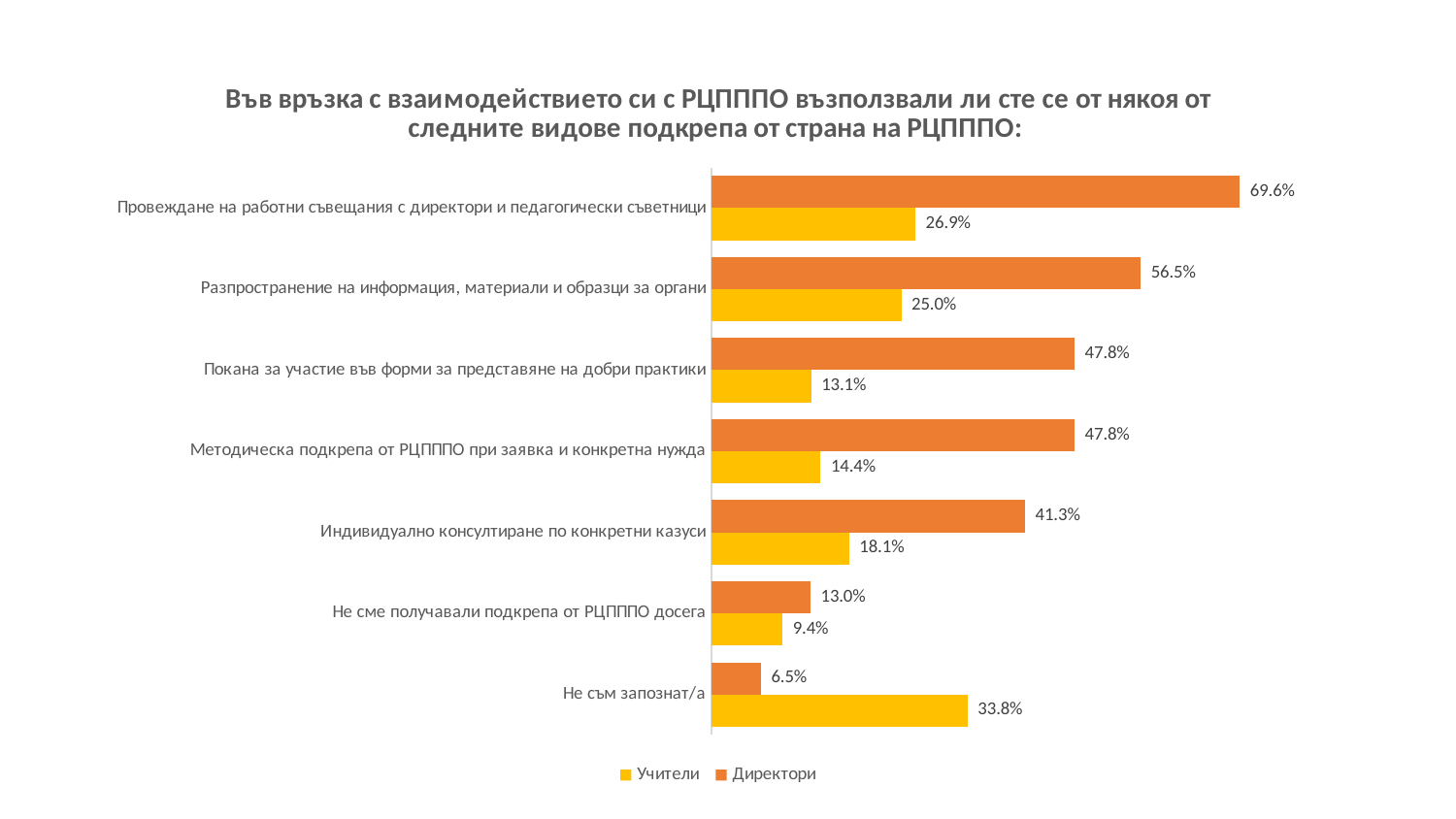
How many series does the legend list? 2 What is the value for Директори for "Не сме получавали подкрепа от РЦПППО досега"? 13.0% What kind of chart is shown on the slide? Bar chart What is the difference between the Директори and Учители values for "Разпространение на информация, материали и образци за органи"? 31.5% What is the value for Директори for "Провеждане на работни съвещания с директори и педагогически съветници"? 69.6% Which colour represents the Директори series? Orange What is the value for Учители for "Индивидуално консултиране по конкретни казуси"? 18.1% Which category has the lowest value for Учители? Не сме получавали подкрепа от РЦПППО досега Which category has the highest value for Директори? Провеждане на работни съвещания с директори и педагогически съветници How many categories are shown in the chart? 7 For "Не съм запознат/а", which series has the larger value, Учители or Директори? Учители What is the value for Учители for "Не съм запознат/а"? 33.8%